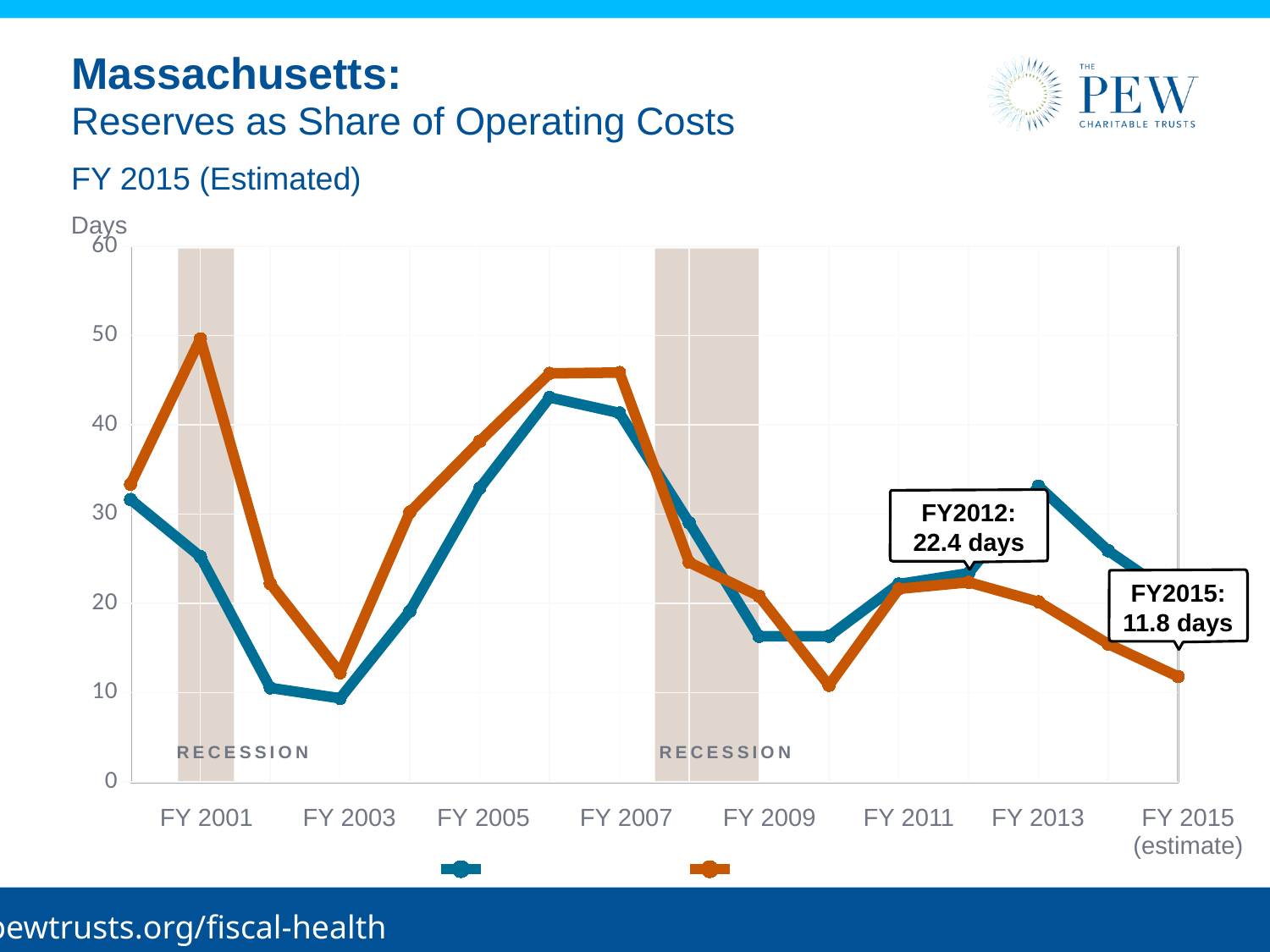
By how many days does the orange line's FY2012 value exceed its FY2015 estimate? 10.6 days What unit is shown on the y axis of the chart? Days Is the value of the orange line at FY 2001 greater or less than 40? greater At FY 2013, which line is higher, the blue line or the orange line? blue line What is the labelled value of the orange line for FY 2015 (estimate)? 11.8 days Does the orange line rise or fall from FY2012 to FY 2015 (estimate)? fall In which fiscal year does the orange line reach its highest value? FY 2001 Is the value of the blue line at FY 2013 greater or less than 30? greater What is the labelled value of the orange line for FY2012? 22.4 days How many series does the legend show? 2 Is the value of the blue line at FY 2003 greater or less than 10? less What kind of chart is shown on the slide? line chart